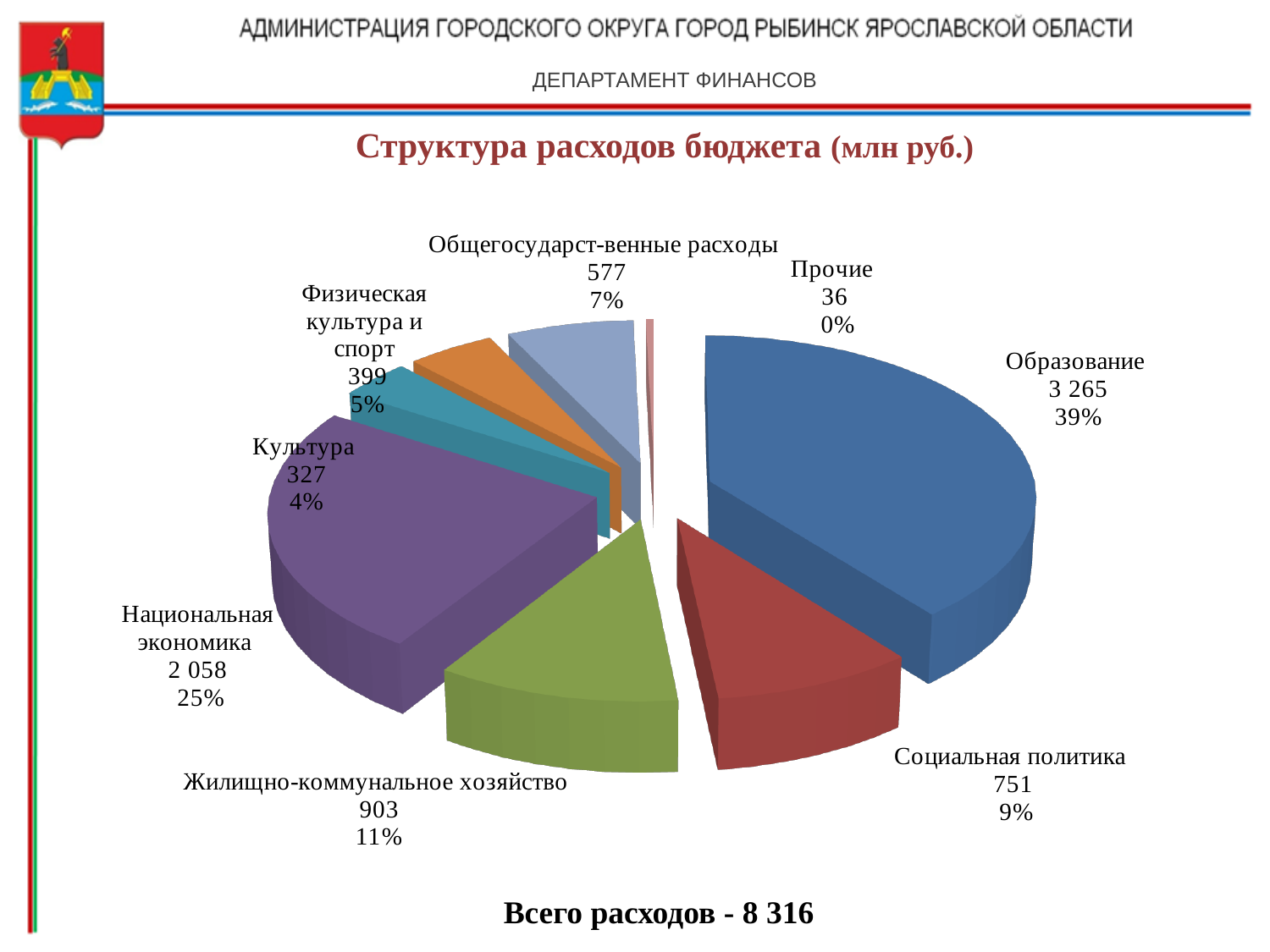
What is the value for Жилищно-коммунальное хозяйство? 903 What is the title of the chart? Структура расходов бюджета (млн руб.) How many categories are shown in the pie chart? 8 What is the value for Социальная политика? 751 What share of the pie does Общегосударственные расходы take? 7% What is the value for Образование? 3 265 What share of the pie does Национальная экономика take? 25% Which category has the largest slice of the pie? Образование What kind of chart is shown on the slide? pie chart Which is larger, the value for Физическая культура и спорт or the value for Культура? Физическая культура и спорт Which category has the smallest slice of the pie? Прочие What is the difference between the values for Образование and Национальная экономика? 1 207